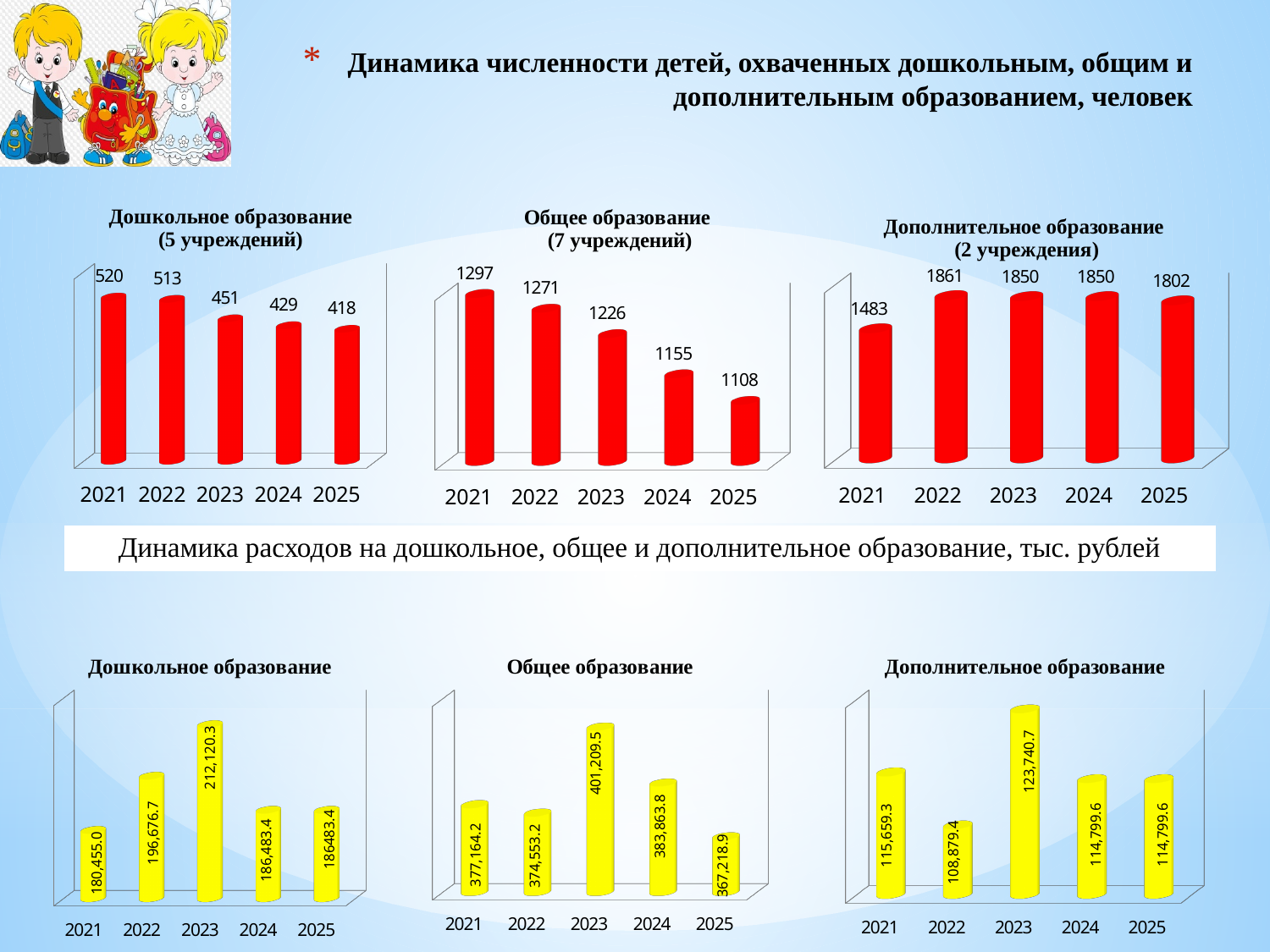
In the top-right chart 'Дополнительное образование (2 учреждения)', which year has the lowest value? 2021 In the top-middle chart 'Общее образование (7 учреждений)', what is the difference between the 2021 and 2025 values? 189 In the top-left chart 'Дошкольное образование (5 учреждений)', do the values rise or fall from 2021 to 2025? fall In the top-middle chart 'Общее образование (7 учреждений)', what is the value for 2025? 1108 In the bottom-left chart 'Дошкольное образование' (expenses), what is the value for 2023? 212,120.3 What type of chart is the top-right chart 'Дополнительное образование (2 учреждения)'? bar chart In the bottom-middle chart 'Общее образование' (expenses), which is larger: the value for 2021 or the value for 2025? 2021 In the bottom-right chart 'Дополнительное образование' (expenses), what is the value for 2022? 108,879.4 In the bottom-middle chart 'Общее образование' (expenses), which year has the highest value? 2023 In the top-right chart 'Дополнительное образование (2 учреждения)', which year has the highest value? 2022 In the top-left chart 'Дошкольное образование (5 учреждений)', what is the value for 2021? 520 How many years (categories) are shown in the top-left chart 'Дошкольное образование (5 учреждений)'? 5